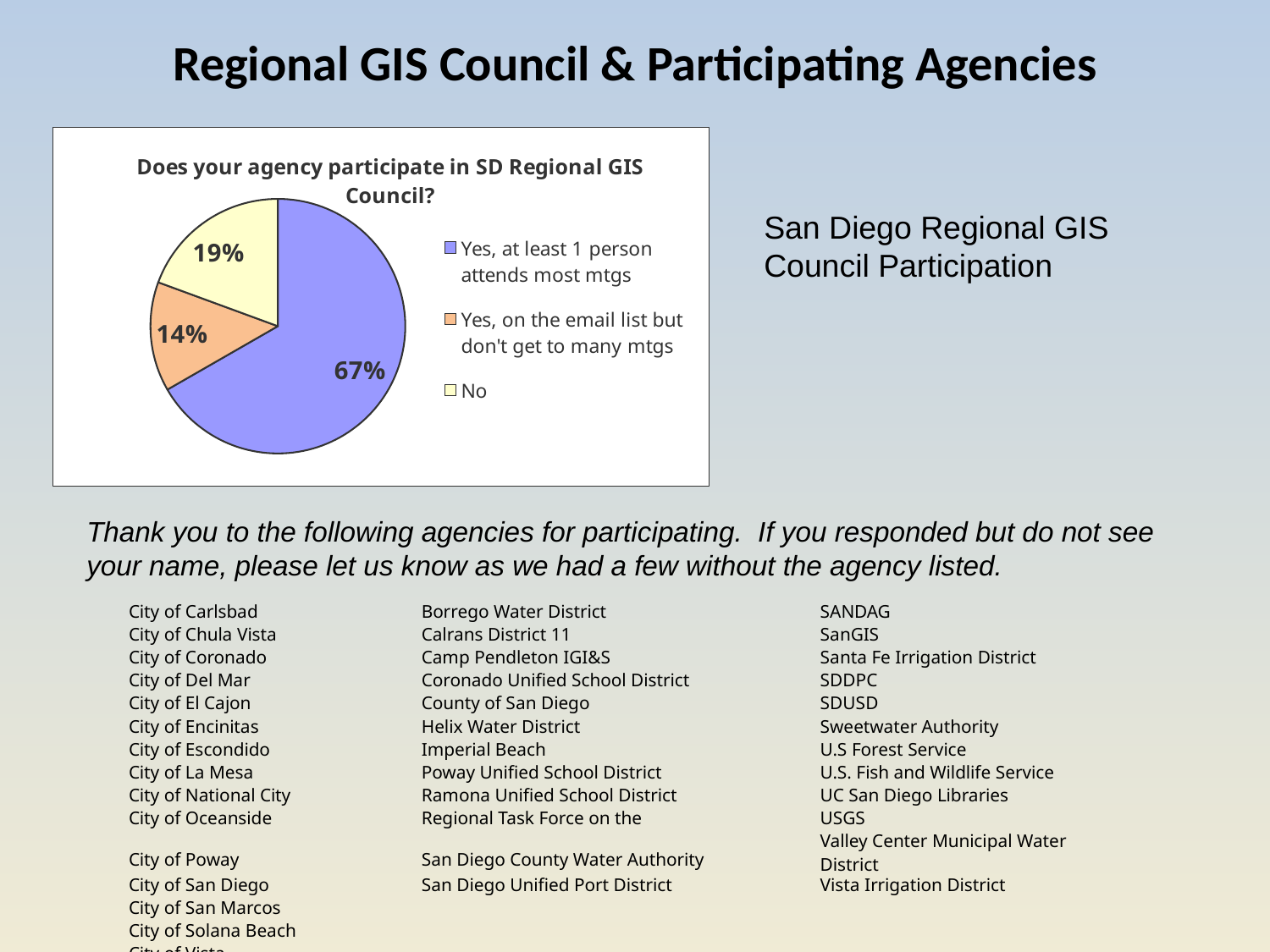
What is the chart's title? Does your agency participate in SD Regional GIS Council? What percentage of agencies answered "Yes, at least 1 person attends most mtgs"? 67% How many entries does the legend list? 3 Which is larger: the "No" slice or the "Yes, on the email list but don't get to many mtgs" slice? No Which response has the smallest share of the pie? Yes, on the email list but don't get to many mtgs What is the difference in percentage points between the "Yes, at least 1 person attends most mtgs" slice and the "No" slice? 48 What percentage of agencies answered "No"? 19% Which response has the largest share of the pie? Yes, at least 1 person attends most mtgs What kind of chart is shown on the slide? pie chart What colour is the "No" slice of the pie? light yellow How many slices does the pie chart have? 3 What percentage of agencies answered "Yes, on the email list but don't get to many mtgs"? 14%